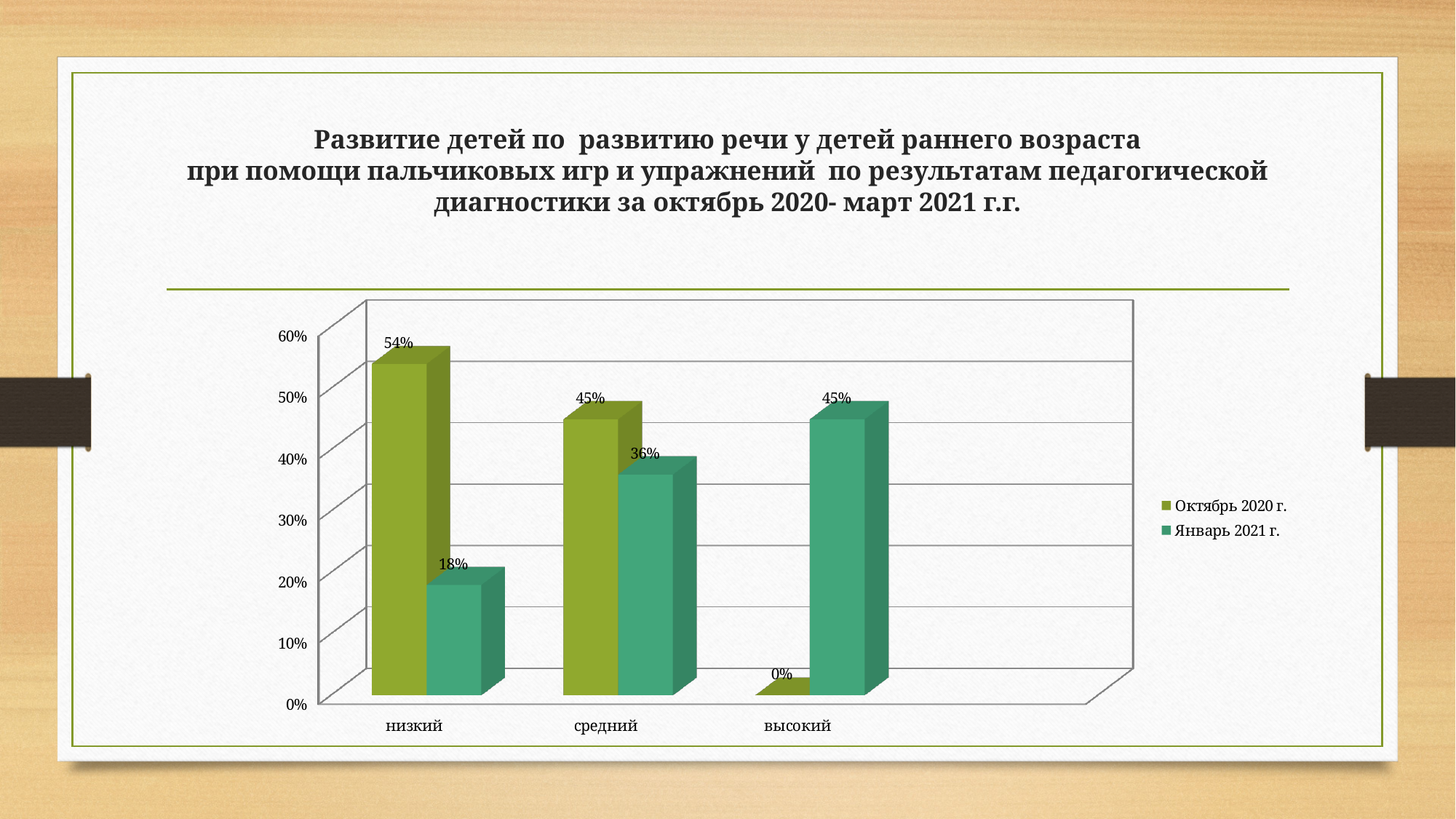
What kind of chart is shown on the slide? bar chart What is the difference between the Октябрь 2020 г. and Январь 2021 г. values for низкий? 36% What is the value for низкий in the Январь 2021 г. series? 18% How many categories are shown on the x axis? 3 Which is larger for средний: the Октябрь 2020 г. value or the Январь 2021 г. value? Октябрь 2020 г. Which category has the highest value in the Октябрь 2020 г. series? низкий Which series is shown in the teal colour in the legend? Январь 2021 г. How many series does the legend list? 2 What is the value for средний in the Январь 2021 г. series? 36% What is the value for высокий in the Октябрь 2020 г. series? 0% Which category has the lowest value in the Январь 2021 г. series? низкий What is the value for низкий in the Октябрь 2020 г. series? 54%